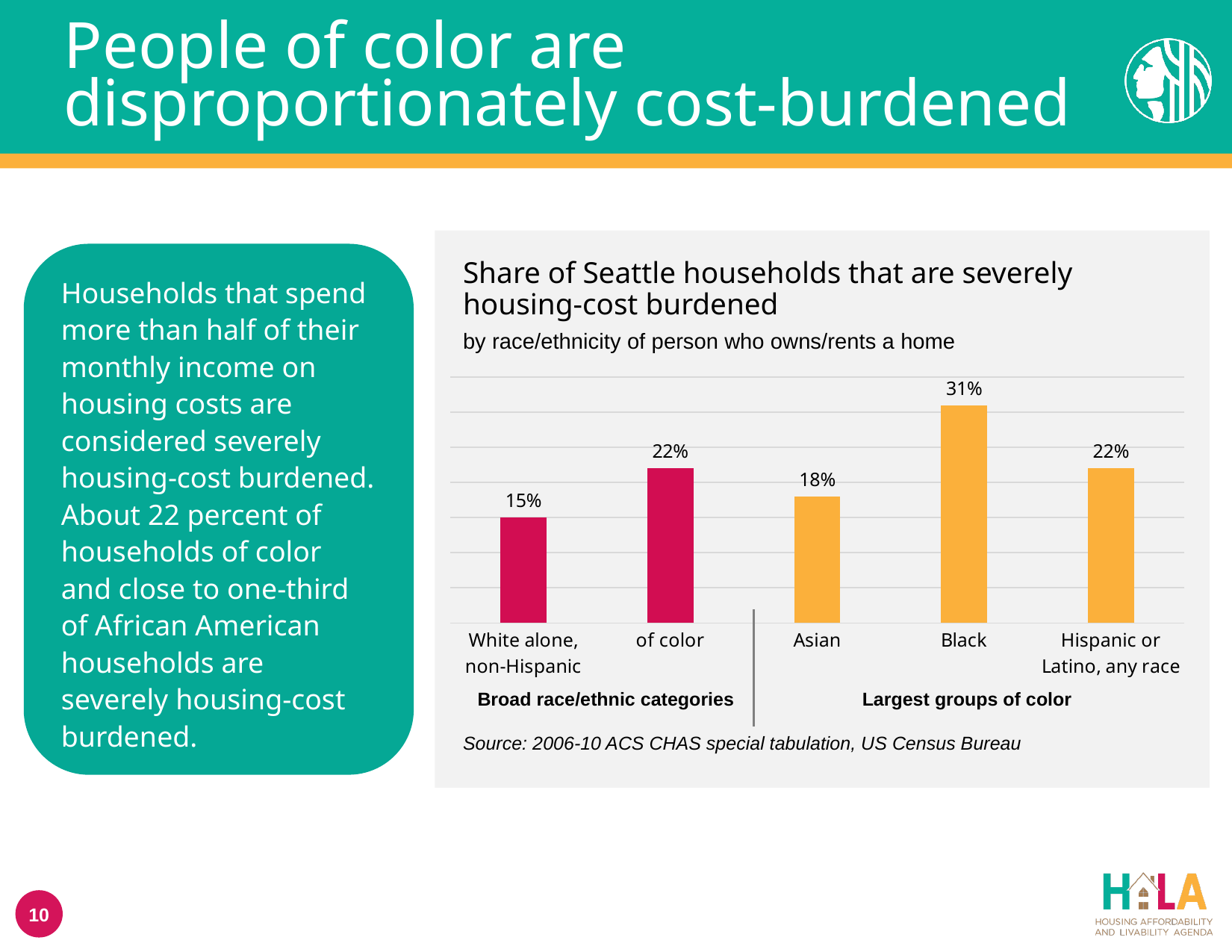
What is the difference between the value for households of color and the value for Asian households? 4% Which category has the lowest share of severely housing-cost burdened households? White alone, non-Hispanic What kind of chart is shown on the slide? Bar chart Which category has the highest share of severely housing-cost burdened households? Black Which is larger, the value for Asian households or the value for Hispanic or Latino, any race households? Hispanic or Latino, any race What is the difference between the value for Black households and the value for White alone, non-Hispanic households? 16% What is the value shown for Black households? 31% How many categories are plotted in the chart? 5 What share of White alone, non-Hispanic households are severely housing-cost burdened? 15% What is the title of the chart? Share of Seattle households that are severely housing-cost burdened What is the value shown for Asian households? 18% What is the value shown for Hispanic or Latino, any race households? 22%